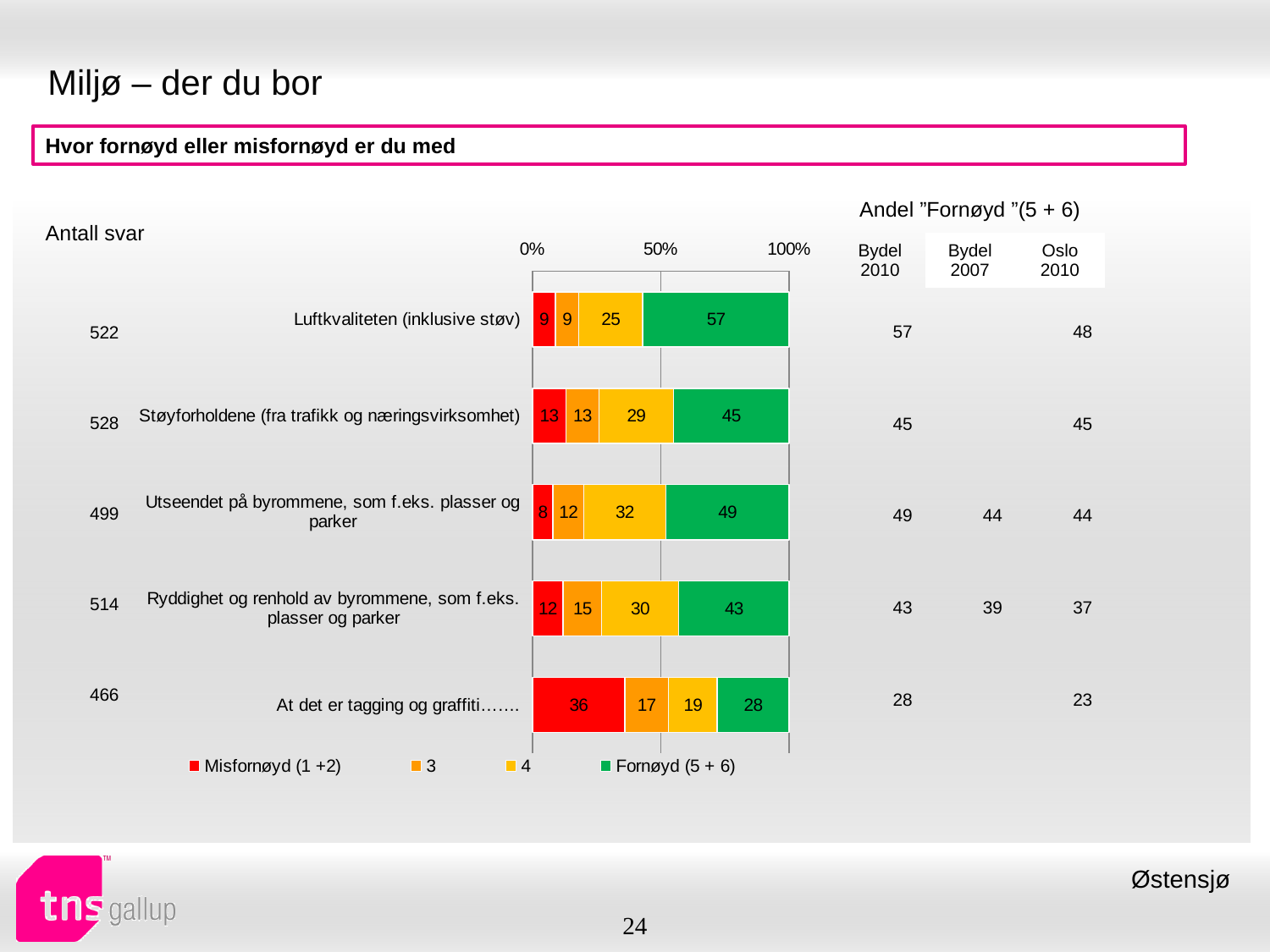
What is the label of the first (red) series in the legend? Misfornøyd (1 +2) Which category has the highest Fornøyd (5 + 6) value? Luftkvaliteten (inklusive støv) What is the difference between the Fornøyd (5 + 6) values for Luftkvaliteten (inklusive støv) and Støyforholdene (fra trafikk og næringsvirksomhet)? 12 What type of chart is shown on the slide? stacked bar chart How many categories (statements) are plotted in the chart? 5 What is the value of series 4 for Utseendet på byrommene, som f.eks. plasser og parker? 32 What is the Misfornøyd (1 +2) value for At det er tagging og graffiti…? 36 What is the Fornøyd (5 + 6) value for Luftkvaliteten (inklusive støv)? 57 Which category has the lowest Fornøyd (5 + 6) value? At det er tagging og graffiti… What is the total of the stacked bar for Ryddighet og renhold av byrommene, som f.eks. plasser og parker? 100 Which has a larger Misfornøyd (1 +2) value: Støyforholdene (fra trafikk og næringsvirksomhet) or Ryddighet og renhold av byrommene, som f.eks. plasser og parker? Støyforholdene (fra trafikk og næringsvirksomhet) How many series does the chart legend list? 4